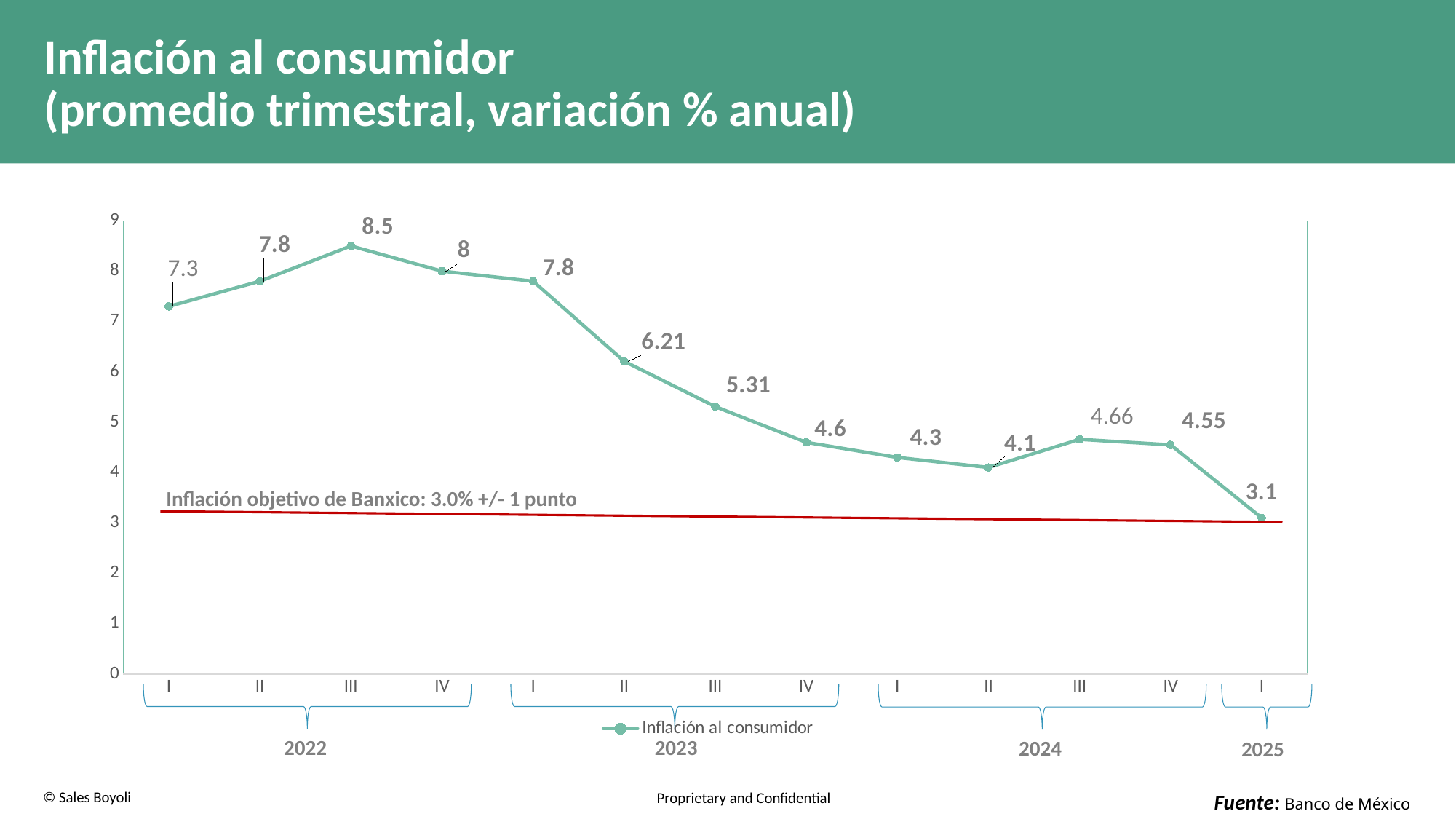
How many series does the legend list? 1 What is the value for quarter III of 2022? 8.5 Which quarter has the highest inflation value? III 2022 What is the difference between the value for quarter III of 2022 and quarter I of 2025? 5.4 What is the Banxico target inflation rate shown on the chart? 3.0% +/- 1 punto What is the value for quarter II of 2023? 6.21 How many quarterly data points are plotted on the chart? 13 What is the value for quarter I of 2025? 3.1 What is the value for quarter III of 2024? 4.66 What type of chart is shown on the slide? line chart Which is larger, the value for quarter IV of 2023 or quarter I of 2024? IV 2023 Which quarter has the lowest inflation value? I 2025